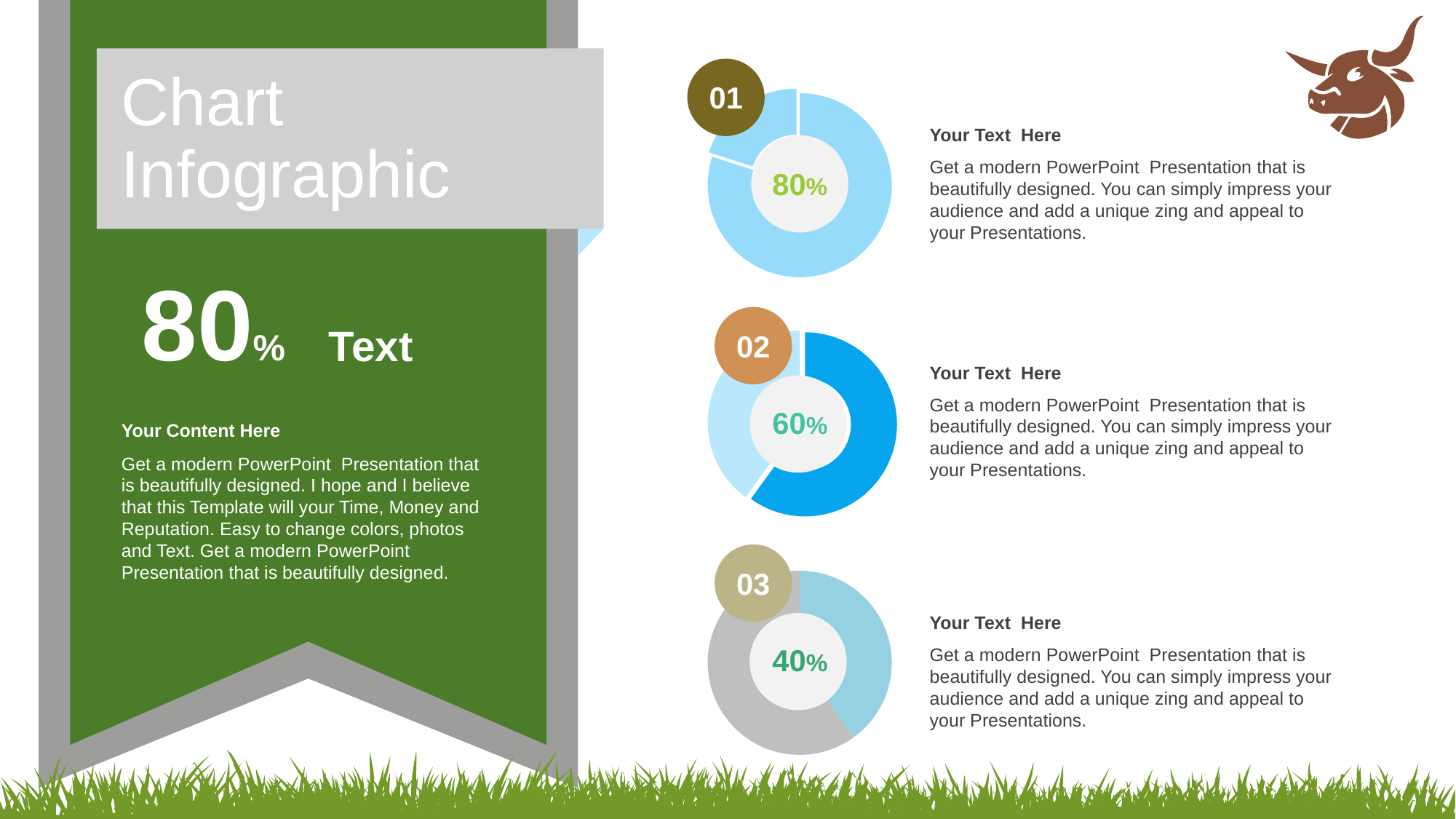
In the donut chart labelled 03 (bottom), what percentage is shown in the centre? 40% What is the difference between the percentage in donut chart 01 and the percentage in donut chart 02? 20% Which shows a larger percentage, donut chart 02 or donut chart 03? 02 In the donut chart labelled 02 (middle), what percentage is shown in the centre? 60% In donut chart 01, what share of the ring is left unfilled by the 80% slice? 20% What kind of chart is used for the three charts on the right side of the slide? Donut (pie) chart What is the difference between the percentage in donut chart 01 and the percentage in donut chart 03? 40% Do the percentages in the donut charts increase or decrease going from the top chart (01) to the bottom chart (03)? Decrease Which of the three donut charts shows the lowest percentage? 03 Which of the three donut charts shows the highest percentage? 01 In the donut chart labelled 01 (top), what percentage is shown in the centre? 80% How many donut charts are on the slide? 3